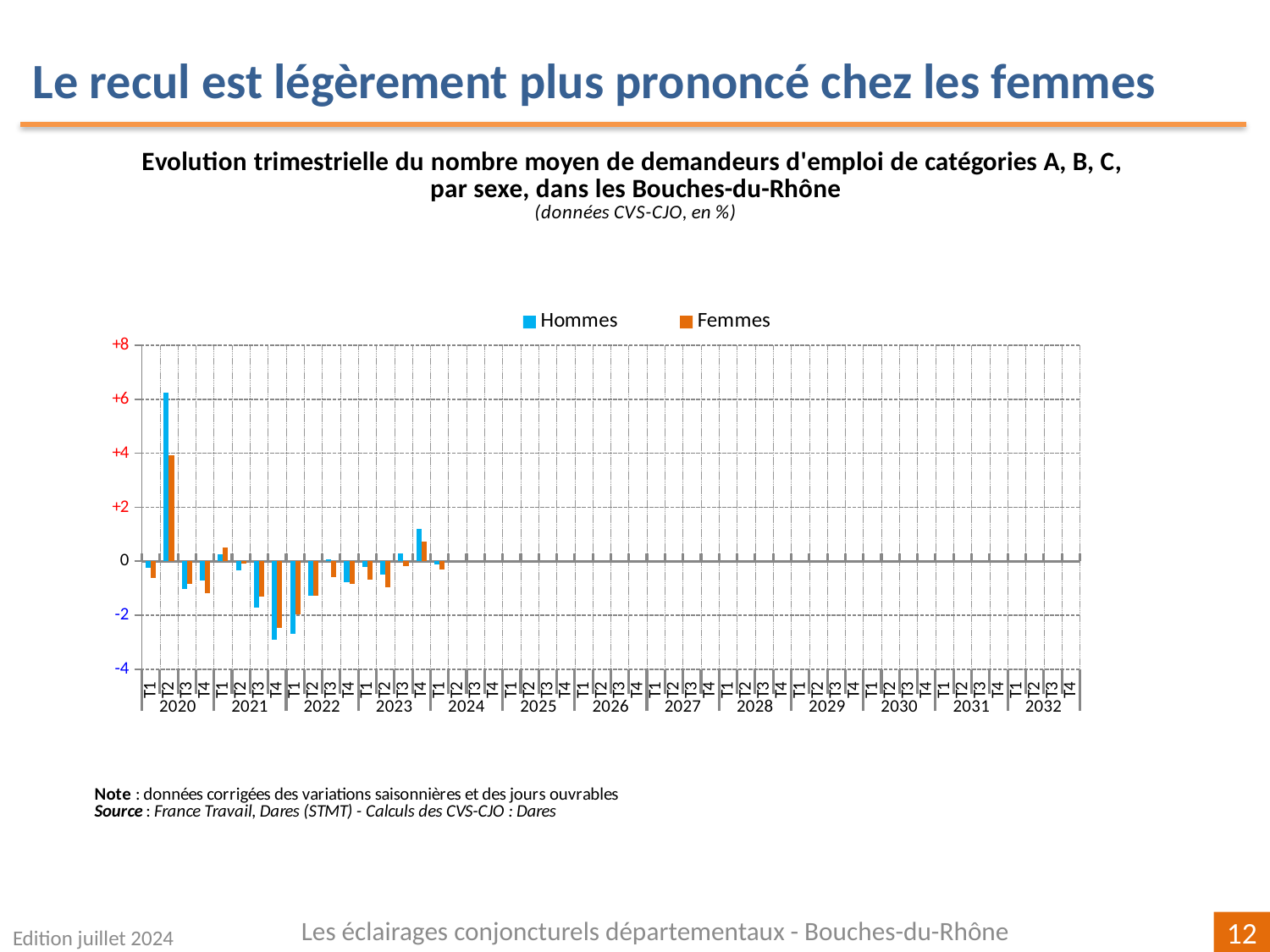
In T2 2020, which series has the larger value, Hommes or Femmes? Hommes How many years are labelled along the x axis? 13 How many series does the legend list? 2 In which quarter does the Hommes series reach its highest value? T2 2020 Is the Hommes value for T4 2020 greater or less than -2? greater In which quarter does the Femmes series reach its highest value? T2 2020 In T4 2023, which series has the larger value, Hommes or Femmes? Hommes Is the Hommes value for T2 2020 greater or less than +4? greater What are the two series named in the legend? Hommes and Femmes What kind of chart is shown on the slide? Bar chart Which colour represents the Femmes series? Orange Is the Femmes value for T2 2020 greater or less than +2? greater